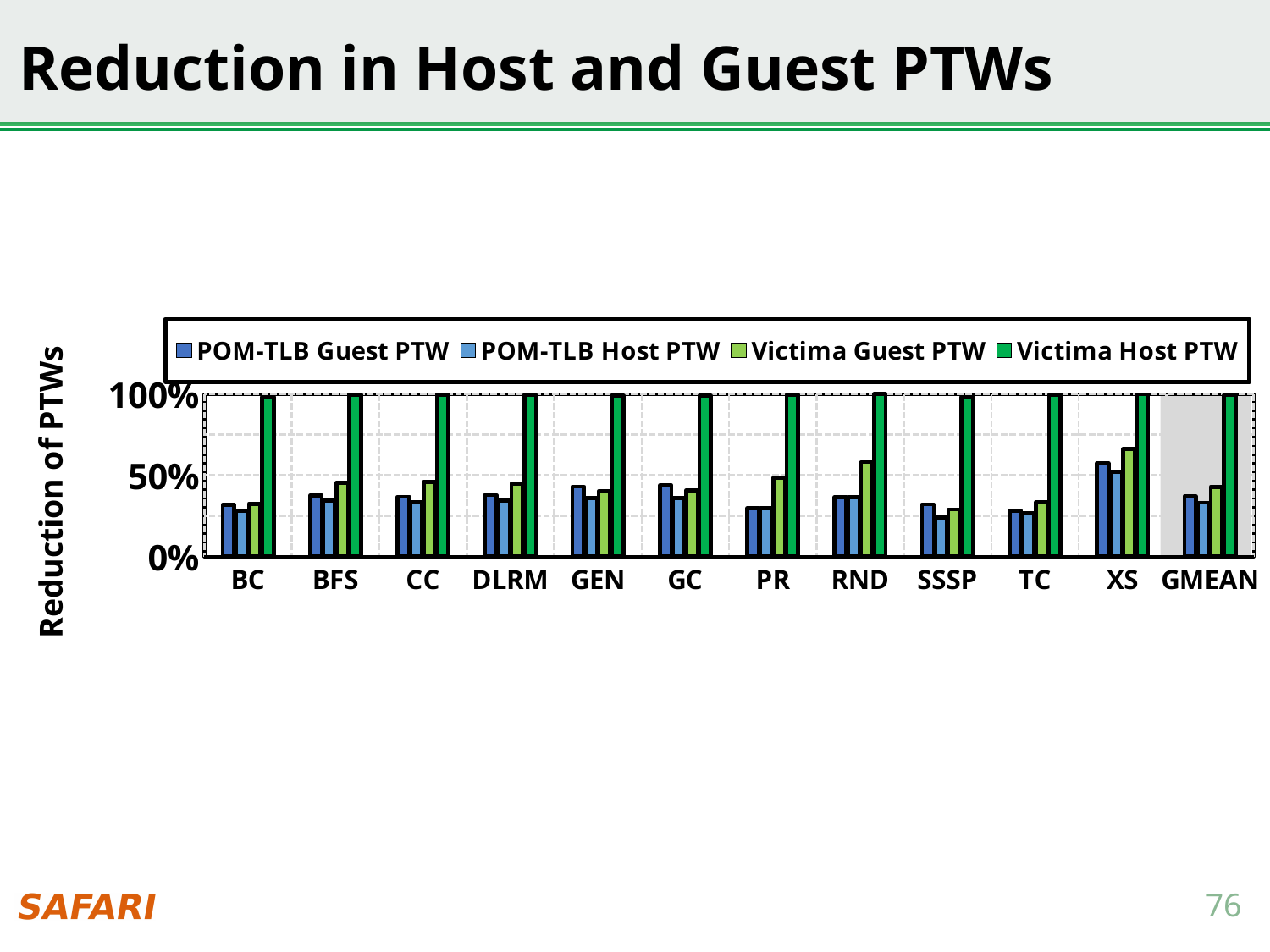
How many categories are shown along the x axis? 12 What is the label on the y axis of the chart? Reduction of PTWs Is the POM-TLB Host PTW value for SSSP greater or less than 50%? less Is the Victima Host PTW value for GMEAN greater or less than 50%? greater Is the Victima Guest PTW value for RND greater or less than 50%? greater For PR, which is larger: the POM-TLB Guest PTW value or the Victima Guest PTW value? Victima Guest PTW What kind of chart is shown on the slide? bar chart What is the title of the slide containing the chart? Reduction in Host and Guest PTWs Which category has the highest Victima Guest PTW value? XS How many series does the legend list? 4